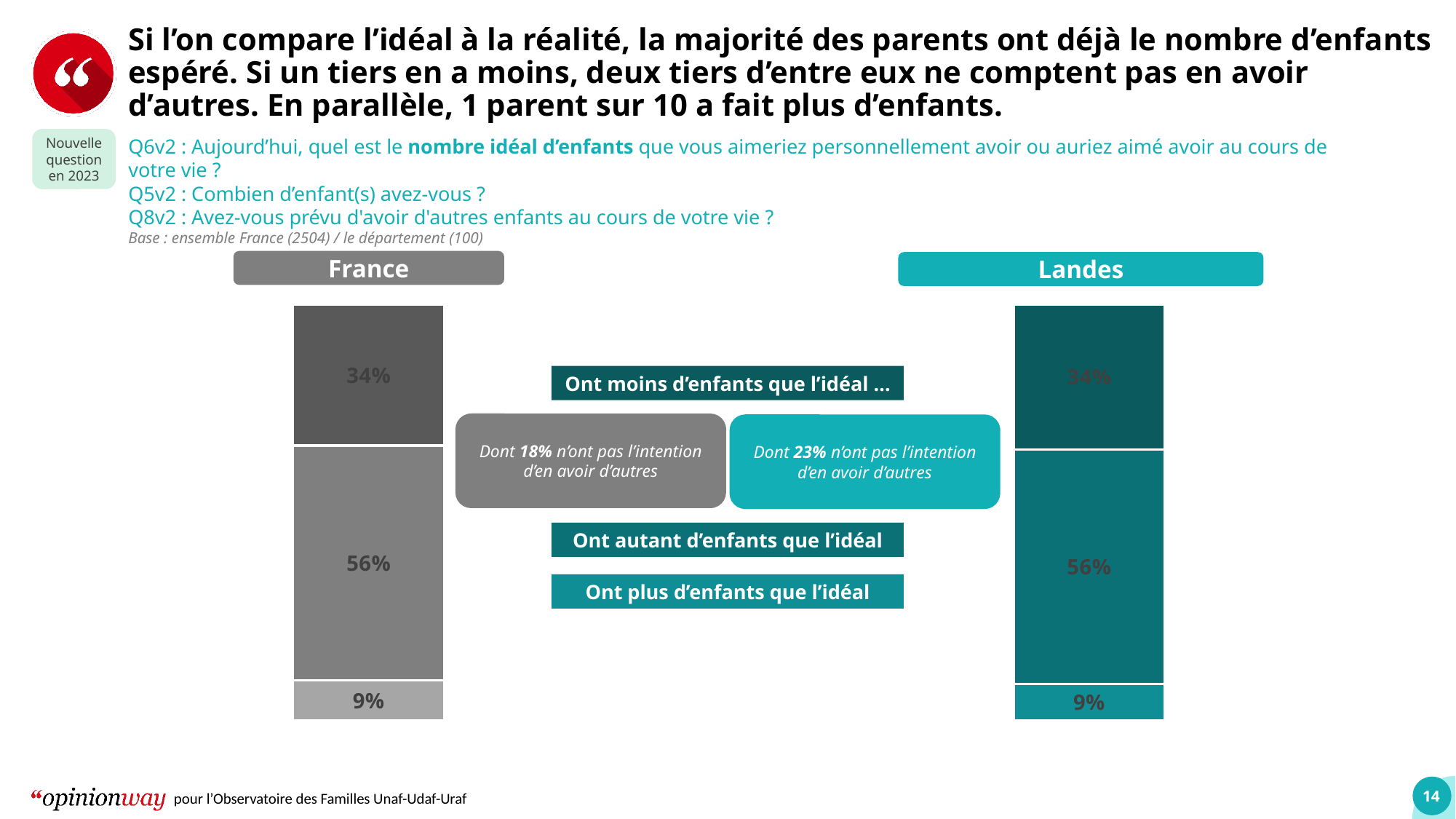
Among parents with fewer children than their ideal, what share in Landes do not intend to have more? 23% In the France chart, what percentage of parents have fewer children than their ideal? 34% In the France chart, which category has the largest share? Ont autant d'enfants que l'idéal In the France chart, what percentage of parents have as many children as their ideal? 56% Among parents with fewer children than their ideal, what share in France do not intend to have more? 18% What kind of chart is used to show the France and Landes results? Stacked bar chart In the Landes chart, which category has the smallest share? Ont plus d'enfants que l'idéal In the Landes chart, what percentage of parents have more children than their ideal? 9% In the Landes chart, what percentage of parents have as many children as their ideal? 56% In the France chart, what is the difference between the share who have as many children as their ideal and the share who have more children than their ideal? 47% Which is larger: the share of parents with fewer children than their ideal who do not intend to have more in France, or in Landes? Landes In the France chart, what percentage of parents have more children than their ideal? 9%